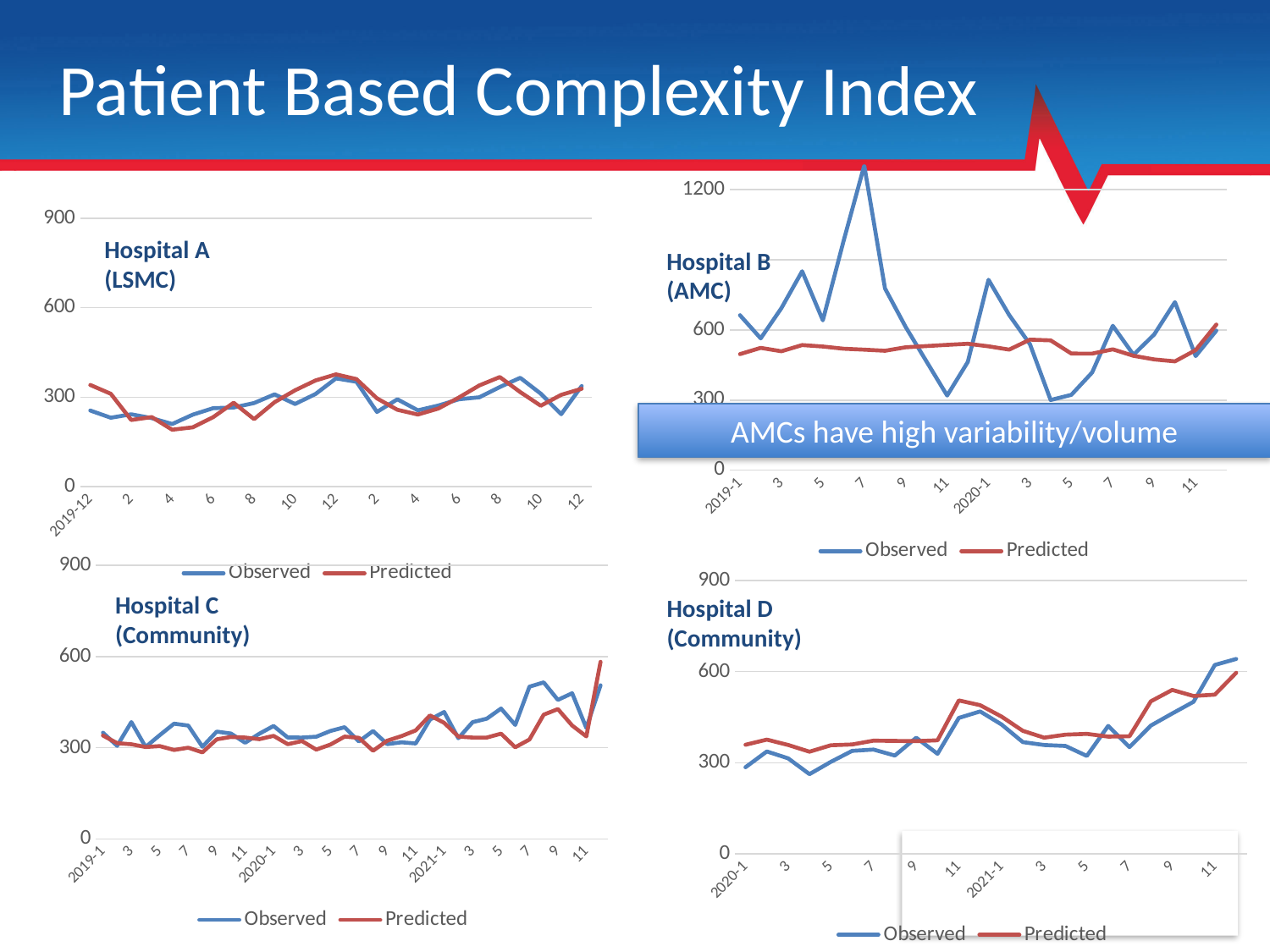
What kind of chart is used for Hospital A (LSMC)? line chart In the Hospital B (AMC) chart, is the Observed value at 2019-7 greater or less than 1200? greater In the Hospital D (Community) chart, is the Observed value at the last point (2021-11) greater or less than 600? greater In the Hospital B (AMC) chart, is the Predicted value at 2019-1 greater or less than 600? less In the Hospital D (Community) chart, which colour is the Predicted line? red Which of the four charts has a y-axis that extends to 1200? Hospital B (AMC) How many charts are shown on the slide? 4 What are the two series named in the legend of the Hospital C (Community) chart? Observed and Predicted How many series does the legend of the Hospital B (AMC) chart list? 2 In the Hospital D (Community) chart, do the Observed values generally rise or fall from 2020-1 to 2021-11? rise